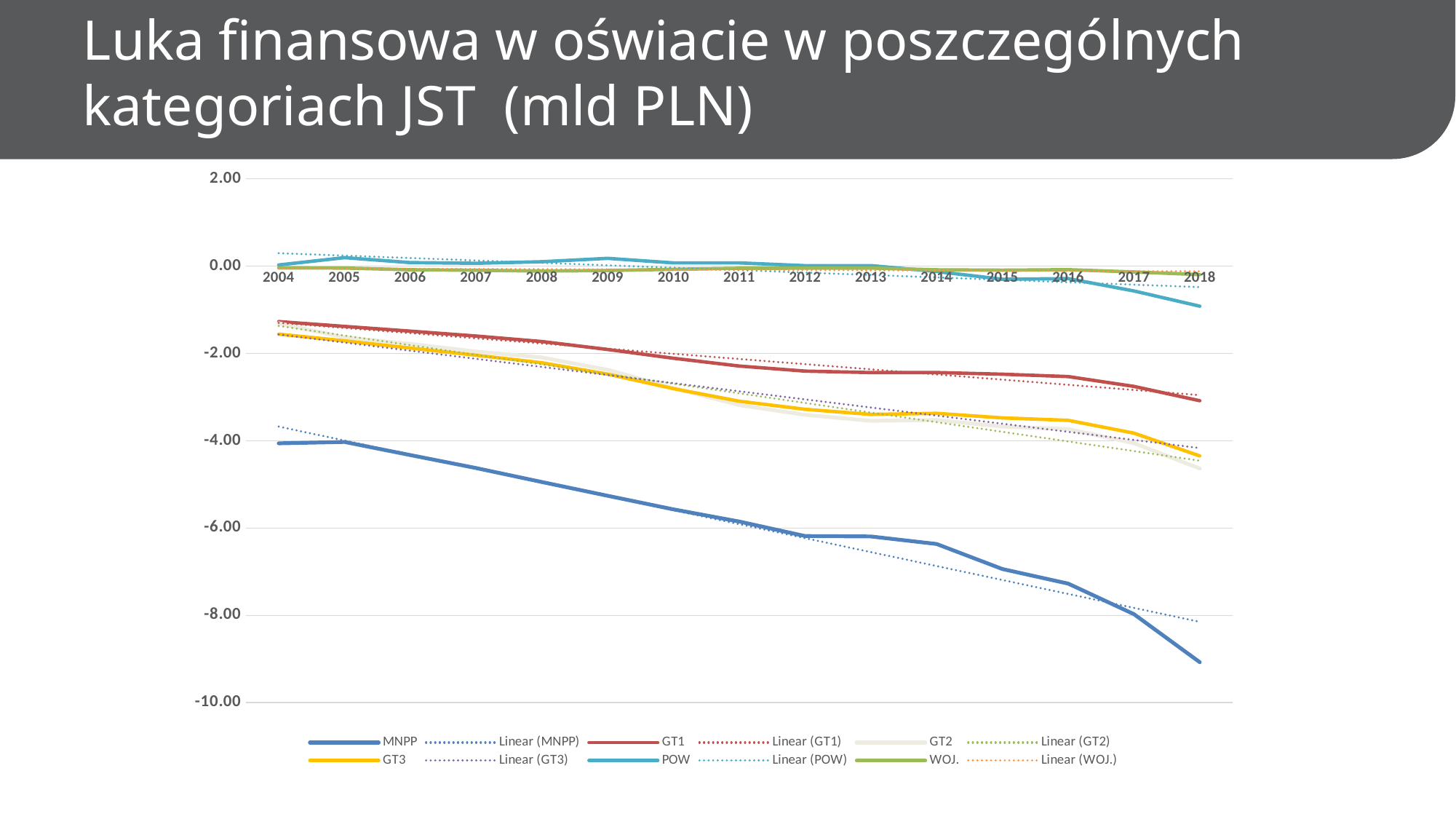
Is the value for GT1 in 2018 greater or less than -2.00? less How many entries does the legend list? 12 Which series has the lowest value in 2018? MNPP How many years are plotted along the x axis? 15 In 2018, which is larger: the value for GT1 or the value for MNPP? GT1 Is the value for MNPP in 2018 greater or less than -8.00? less Is the value for MNPP in 2004 greater or less than -6.00? greater In 2010, which is larger: the value for GT1 or the value for GT3? GT1 Does the MNPP series rise or fall from 2004 to 2018? fall What kind of chart is shown on the slide? line chart What is the title of the slide containing the chart? Luka finansowa w oświacie w poszczególnych kategoriach JST (mld PLN)